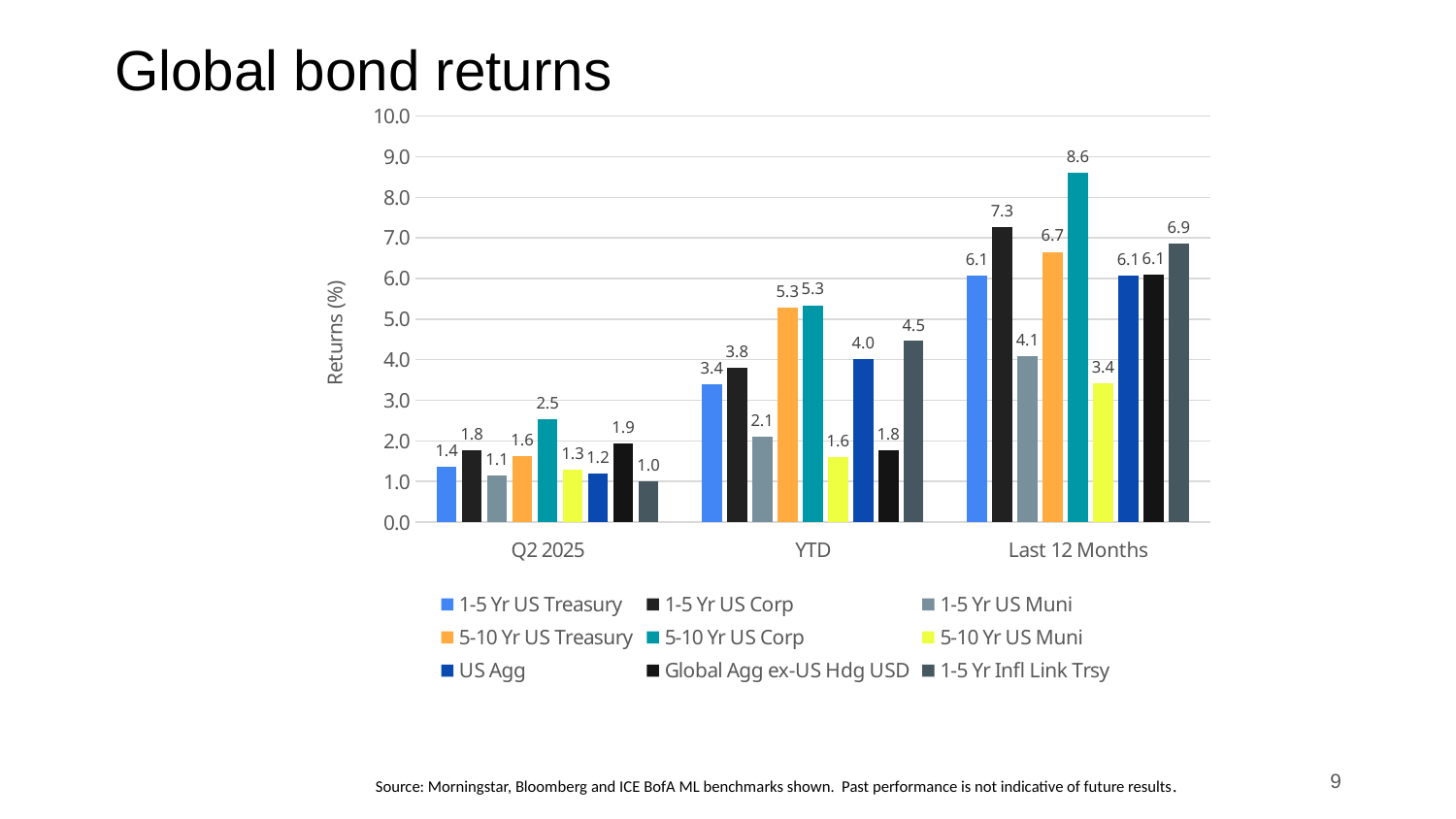
Does the return for 5-10 Yr US Treasury rise or fall from Q2 2025 to Last 12 Months? rise Which series has the highest return in the Last 12 Months category? 5-10 Yr US Corp What label is shown on the y axis of the chart? Returns (%) Which series has the lowest return in Q2 2025? 1-5 Yr Infl Link Trsy What is the return for 1-5 Yr US Treasury in Q2 2025? 1.4 Which is larger in the YTD category: the return for US Agg or the return for 1-5 Yr US Muni? US Agg How many series does the legend list? 9 What is the return for 5-10 Yr US Corp in the Last 12 Months category? 8.6 How many categories are shown on the x axis? 3 What type of chart is shown on the slide? bar chart What is the difference between the Last 12 Months returns of 5-10 Yr US Corp and 5-10 Yr US Muni? 5.2 What is the return for 5-10 Yr US Muni in the YTD category? 1.6